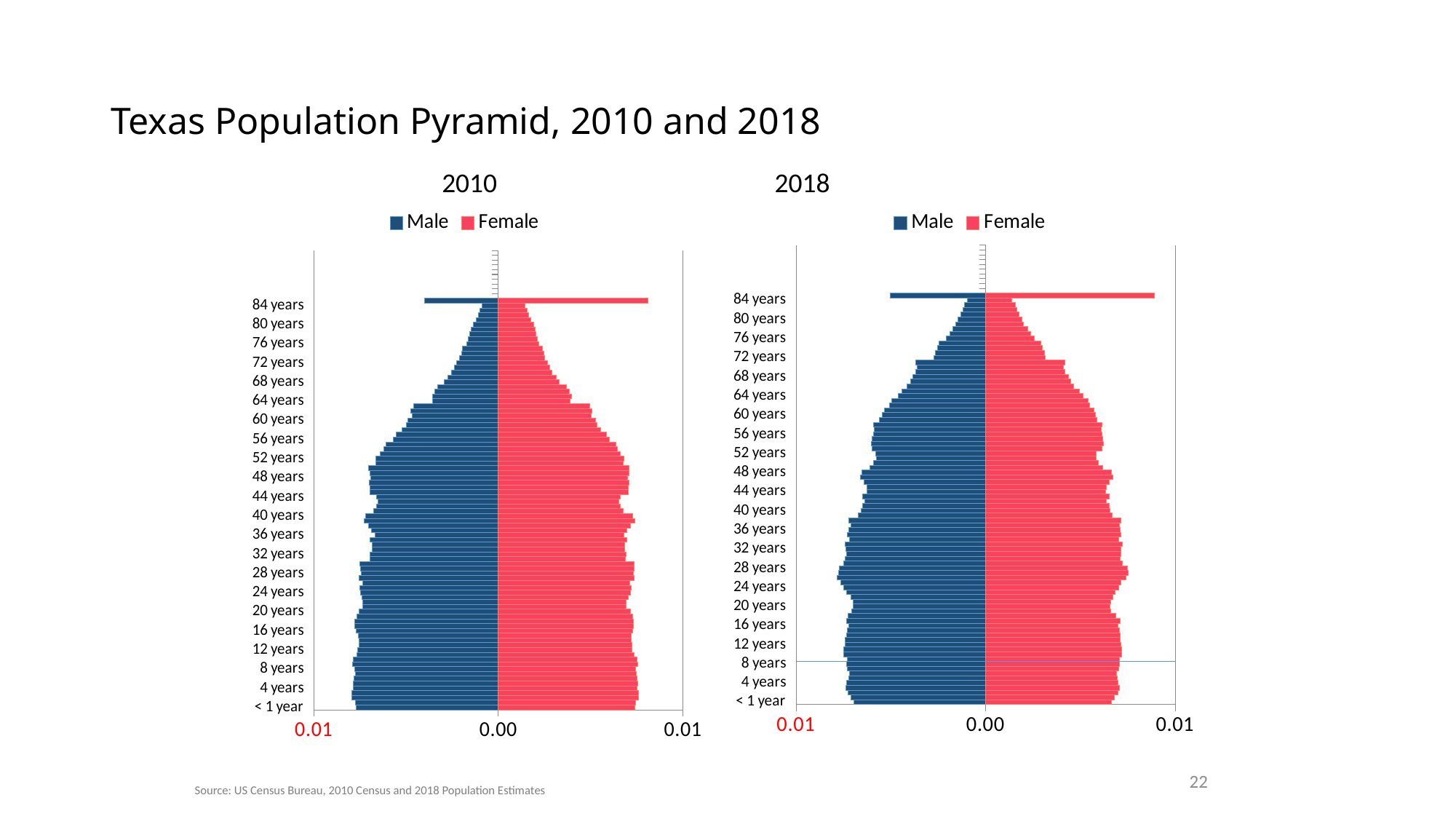
In the 2018 chart, is the Female value for 84 years greater or less than 0.01? less In the 2018 chart, which Female bar is longer, 28 years or 76 years? 28 years What kind of chart is the 2010 chart? Bar chart What is the title of the slide? Texas Population Pyramid, 2010 and 2018 In the 2010 chart, which Male bar is longer, 28 years or 72 years? 28 years How many series does the legend of the 2018 chart list? 2 In the 2010 chart, do the Male bars generally get shorter or longer as age increases from 40 years to 80 years? Shorter What are the two series named in the legend of the 2010 chart? Male and Female